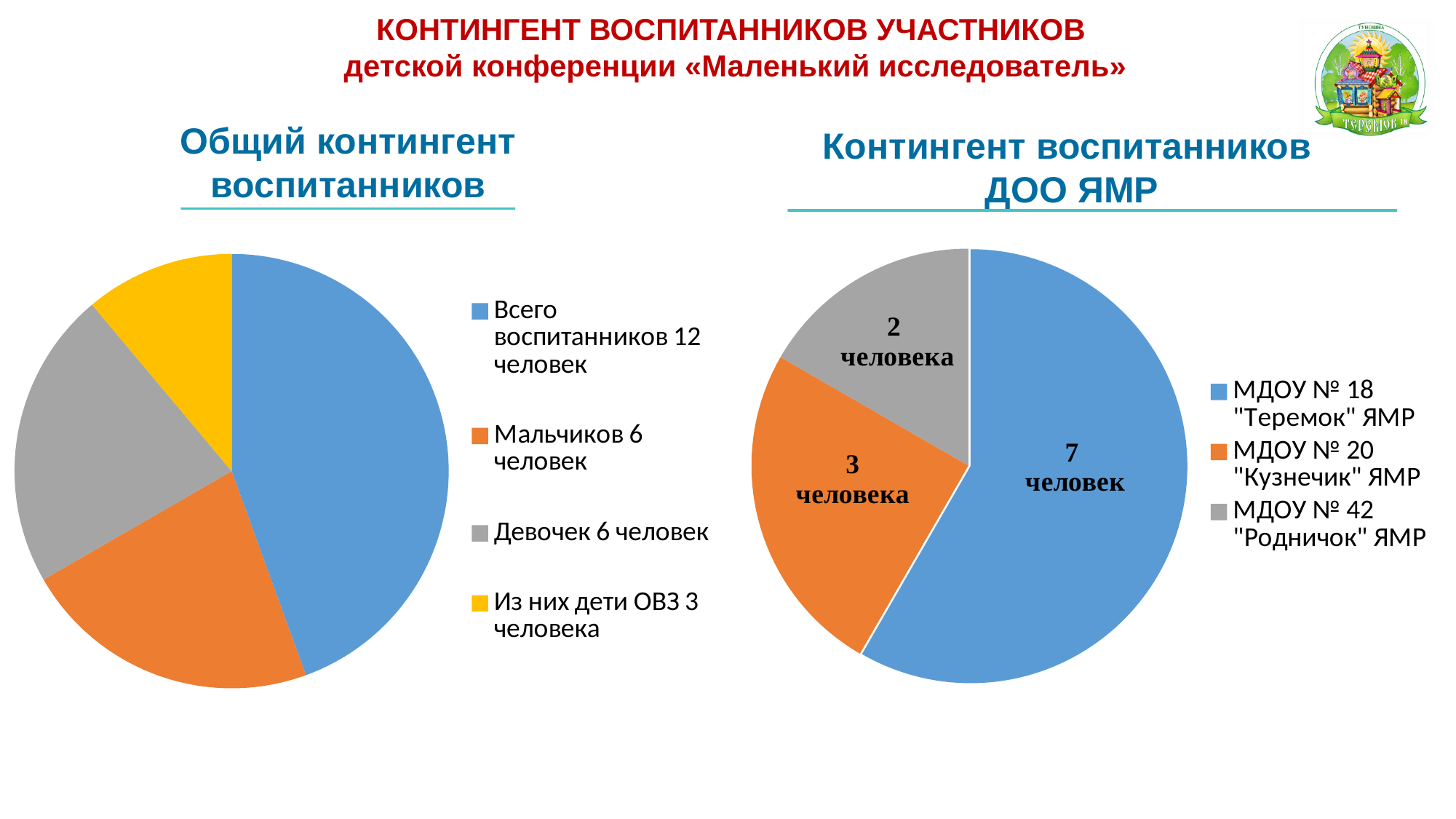
What kind of chart is the chart titled "Контингент воспитанников ДОО ЯМР"? Pie chart In the chart titled "Контингент воспитанников ДОО ЯМР", what is the value for МДОУ № 18 "Теремок" ЯМР? 7 человек In the chart titled "Контингент воспитанников ДОО ЯМР", how many more people are from МДОУ № 18 "Теремок" ЯМР than from МДОУ № 20 "Кузнечик" ЯМР? 4 In the chart titled "Контингент воспитанников ДОО ЯМР", how many categories are shown? 3 In the chart titled "Общий контингент воспитанников", how many categories does the legend list? 4 In the chart titled "Контингент воспитанников ДОО ЯМР", what is the value for МДОУ № 20 "Кузнечик" ЯМР? 3 человека In the chart titled "Общий контингент воспитанников", which category has the largest slice? Всего воспитанников 12 человек In the chart titled "Контингент воспитанников ДОО ЯМР", which category has the smallest slice? МДОУ № 42 "Родничок" ЯМР In the chart titled "Общий контингент воспитанников", how many people are listed for "Из них дети ОВЗ"? 3 человека In the chart titled "Общий контингент воспитанников", what colour is the slice for "Мальчиков 6 человек"? Orange In the chart titled "Контингент воспитанников ДОО ЯМР", which category has the largest slice? МДОУ № 18 "Теремок" ЯМР In the chart titled "Контингент воспитанников ДОО ЯМР", what is the value for МДОУ № 42 "Родничок" ЯМР? 2 человека